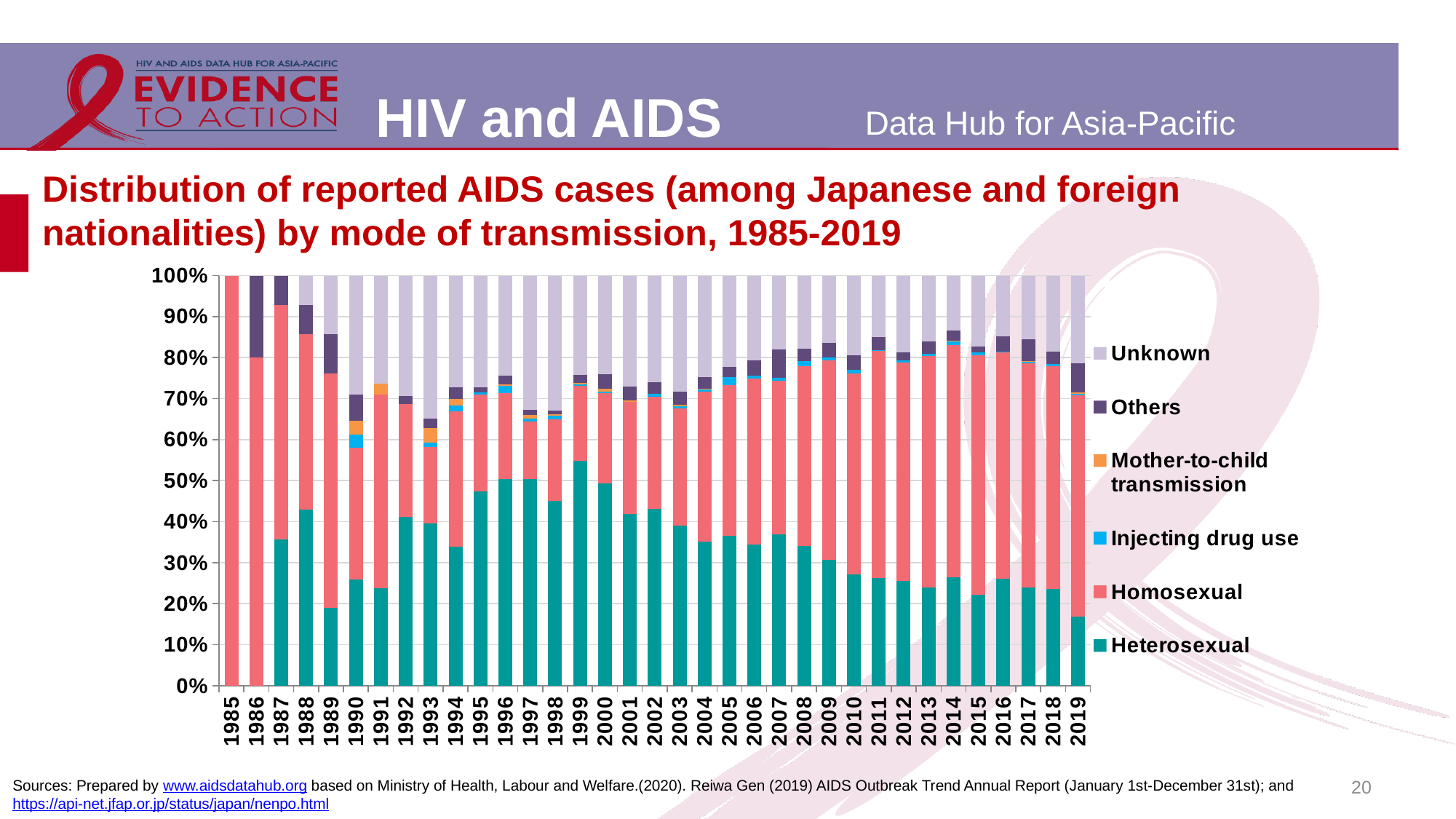
Does the Homosexual share of cases rise or fall from 1999 to 2011? Rise What kind of chart is shown on the slide? Stacked bar chart Which year has the highest Heterosexual share of reported AIDS cases? 1999 Is the Heterosexual share in 2015 greater or less than 30%? less Is the Heterosexual share in 2019 greater or less than 20%? less How many years are plotted along the x axis? 35 Is the Heterosexual share in 1999 greater or less than 50%? greater Which legend entry is shown in light purple at the top of the bars? Unknown What share of reported AIDS cases in 1985 is attributed to Homosexual transmission? 100% Which year has the larger Heterosexual share, 1996 or 1989? 1996 Which series is shown in teal at the bottom of the bars? Heterosexual How many series does the legend list? 6